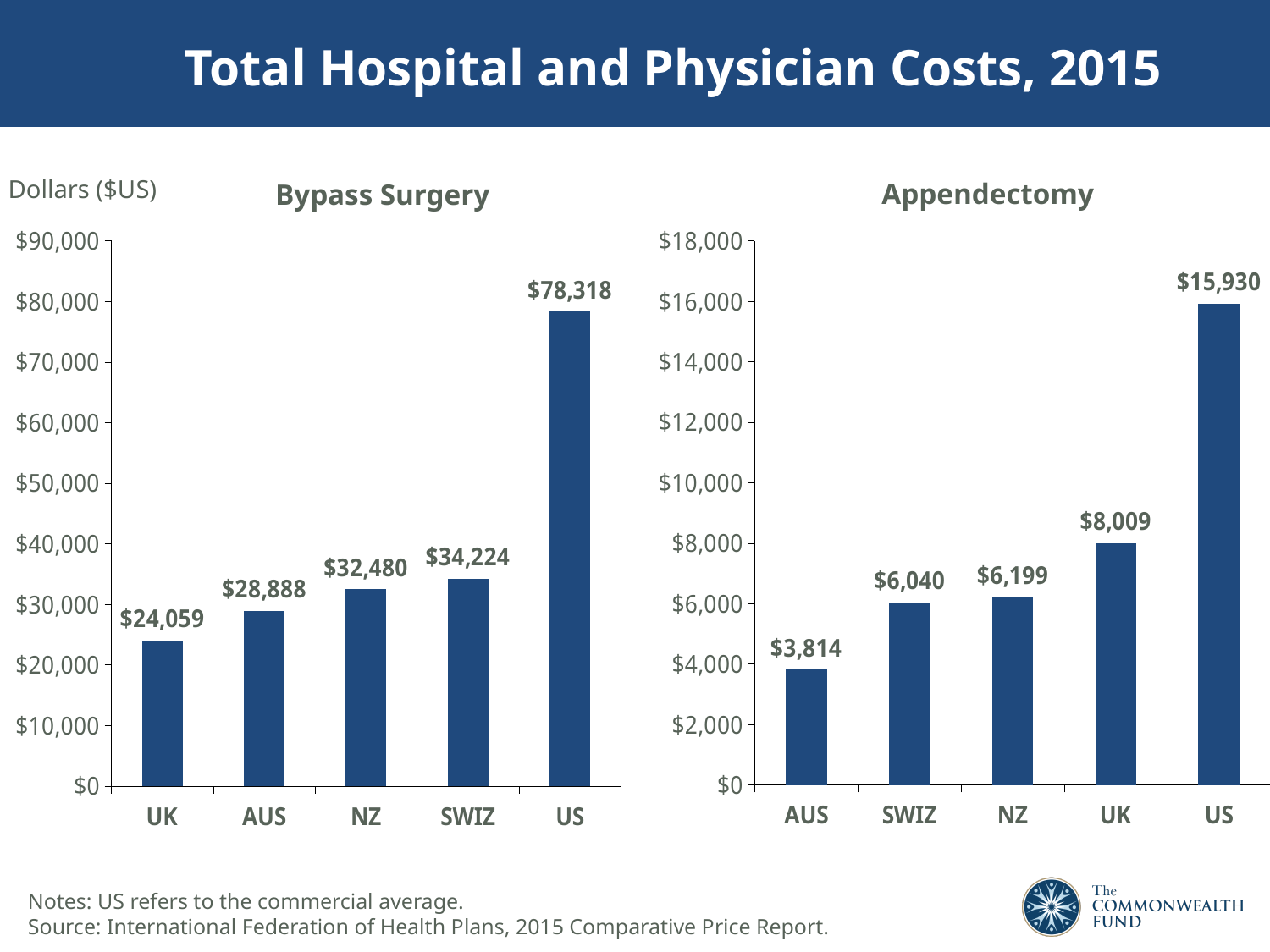
In the Bypass Surgery chart, what is the difference between the US and UK values? $54,259 In the Appendectomy chart, do the values rise or fall from left to right? Rise In the Appendectomy chart, which country has the highest cost? US What kind of chart is the Appendectomy chart? Bar chart In the Bypass Surgery chart, which is larger, the value for NZ or the value for AUS? NZ In the Bypass Surgery chart, which country has the lowest cost? UK What unit is shown for the values on the slide? Dollars ($US) In the Bypass Surgery chart, what is the value for the US? $78,318 In the Appendectomy chart, what is the difference between the UK and AUS values? $4,195 How many countries are shown in the Bypass Surgery chart? 5 In the Appendectomy chart, what is the value for SWIZ? $6,040 In the Appendectomy chart, is the value for NZ greater or less than $8,000? less